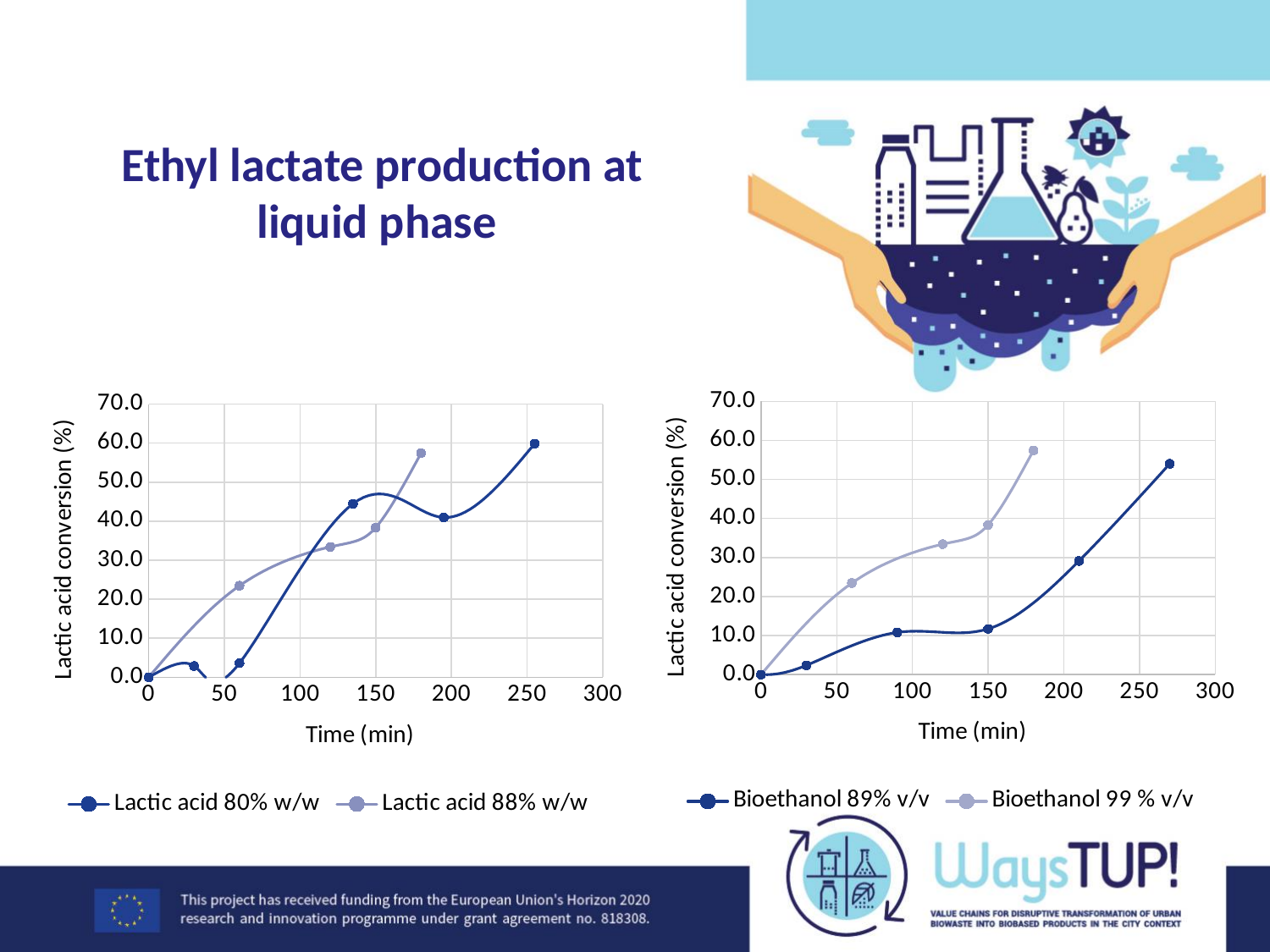
In the left chart, which series has the higher lactic acid conversion at 60 min, Lactic acid 80% w/w or Lactic acid 88% w/w? Lactic acid 88% w/w What is the y-axis label of the right chart? Lactic acid conversion (%) How many data points are plotted for the Lactic acid 88% w/w series in the left chart? 5 In the left chart, is the final value of the Lactic acid 88% w/w series (at 180 min) greater or less than 50? greater What are the two series named in the legend of the left chart? Lactic acid 80% w/w and Lactic acid 88% w/w In the right chart, does the Bioethanol 99 % v/v series rise or fall as time increases? Rises In the right chart, is the final value of Bioethanol 89% v/v (at 270 min) greater or less than 50? greater What type of chart is the left chart on the slide? Line chart How many series does the legend of the right chart list? 2 In the right chart, which series has the higher lactic acid conversion at 150 min, Bioethanol 89% v/v or Bioethanol 99 % v/v? Bioethanol 99 % v/v How many data points are plotted for the Bioethanol 89% v/v series in the right chart? 6 In the right chart, is the value of Bioethanol 89% v/v at 150 min greater or less than 20? less